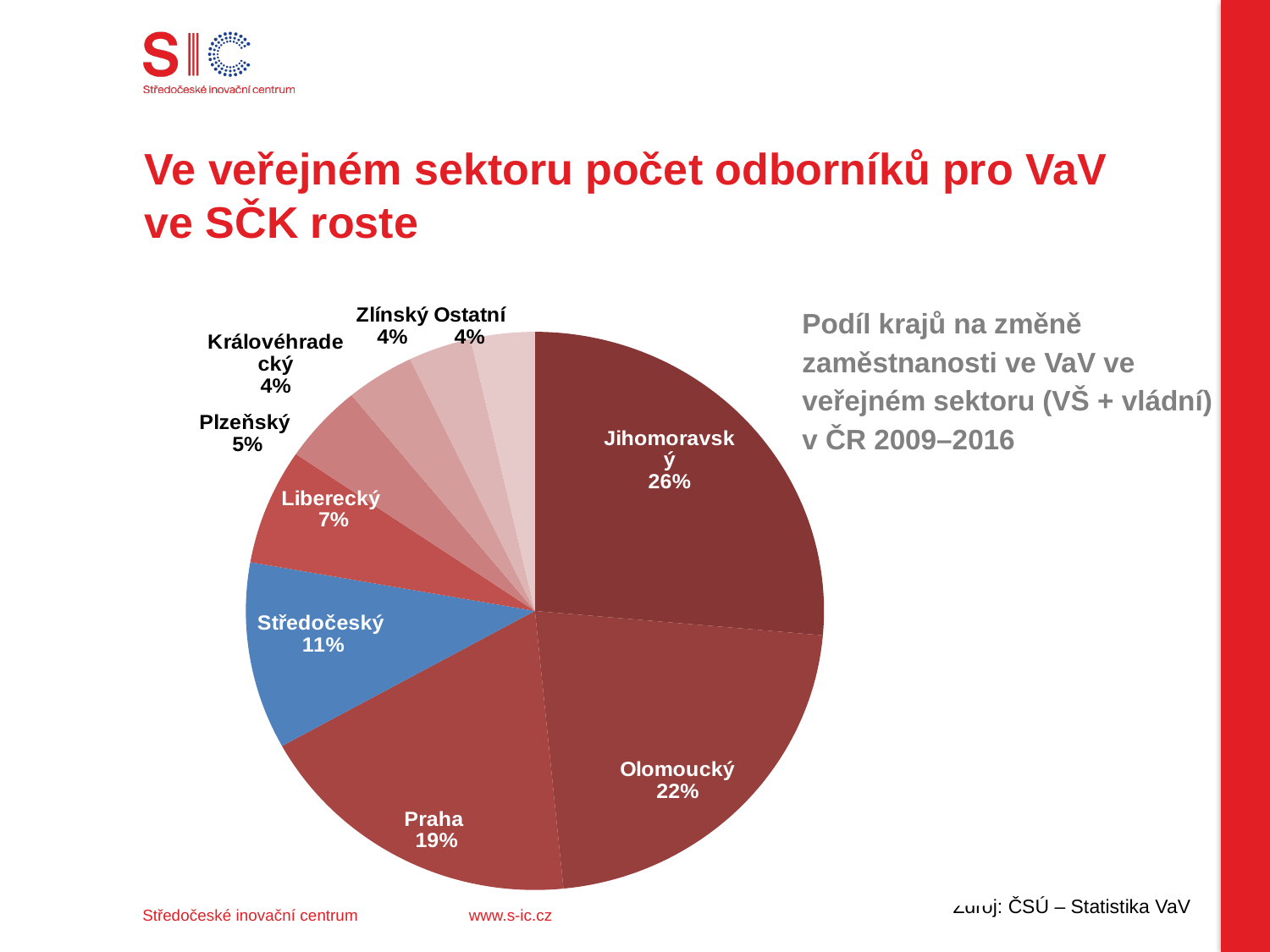
What share of the pie does Olomoucký have? 22% Which slice of the pie is coloured blue? Středočeský What share of the pie does Liberecký have? 7% What share of the pie does Plzeňský have? 5% How many slices does the pie chart have? 9 What kind of chart is shown on the slide? pie chart Which slice is larger, Praha or Olomoucký? Olomoucký What is the difference in percentage points between the Jihomoravský and Středočeský slices? 15 Which region has the largest slice of the pie? Jihomoravský